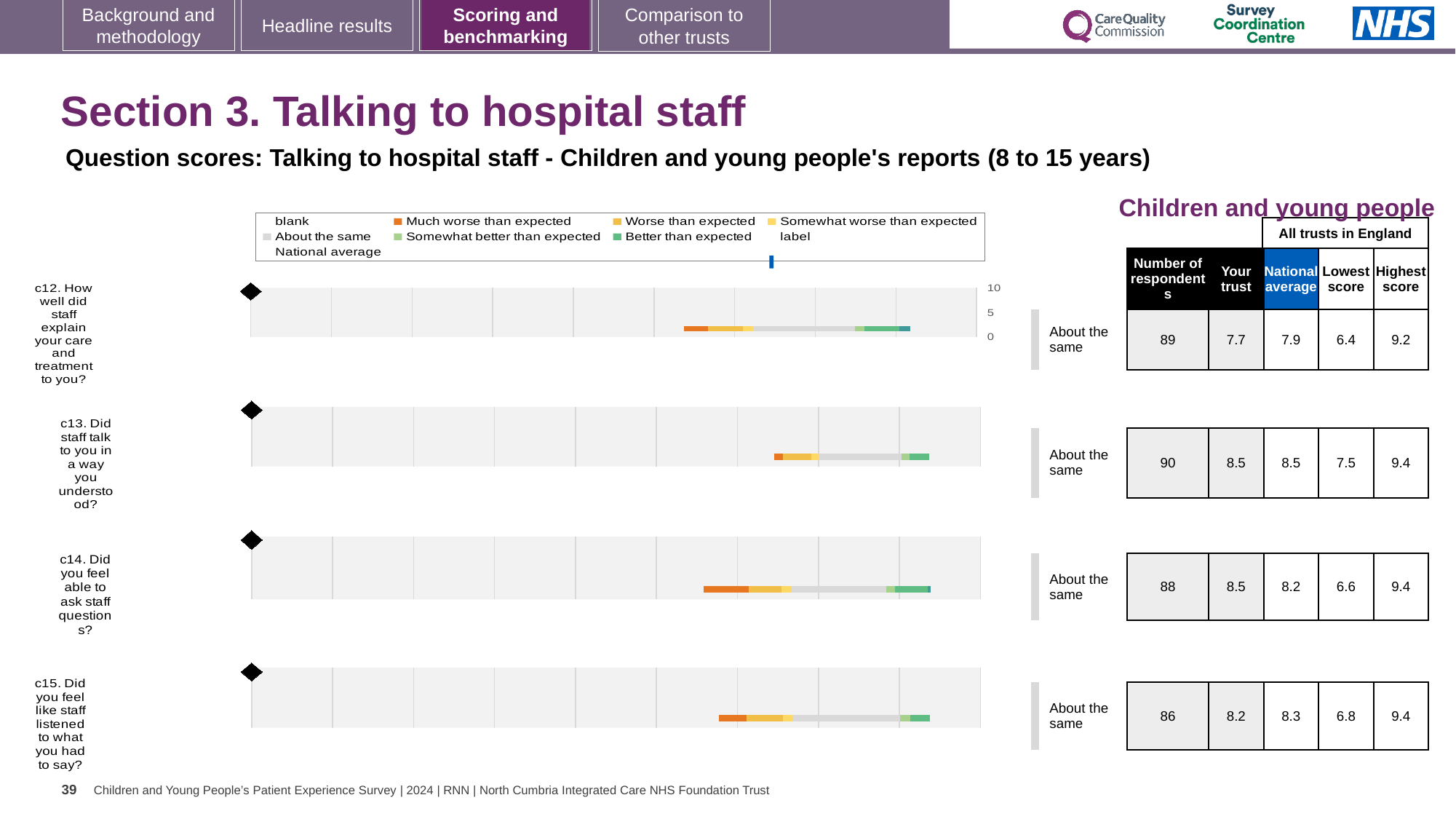
Which question has the largest number of respondents? c13 What is the difference between the Highest score and the Lowest score for c12? 2.8 What benchmark label is shown next to each of the four question charts? About the same Which question has the lowest 'Your trust' score in the table? c12 In the table, what is the National average for c15 (Did you feel like staff listened to what you had to say?)? 8.3 In the table, what is the 'Your trust' score for c12 (How well did staff explain your care and treatment to you?)? 7.7 For c15, which is larger: the 'Your trust' score or the National average? National average What is the Lowest score across all trusts in England for c13 (Did staff talk to you in a way you understood?)? 7.5 What is the Highest score across all trusts in England for c12? 9.2 How many respondents answered c14 (Did you feel able to ask staff questions?)? 88 What kind of chart is used for each question on the slide? bar chart How many survey questions (c12 to c15) are charted on the slide? 4